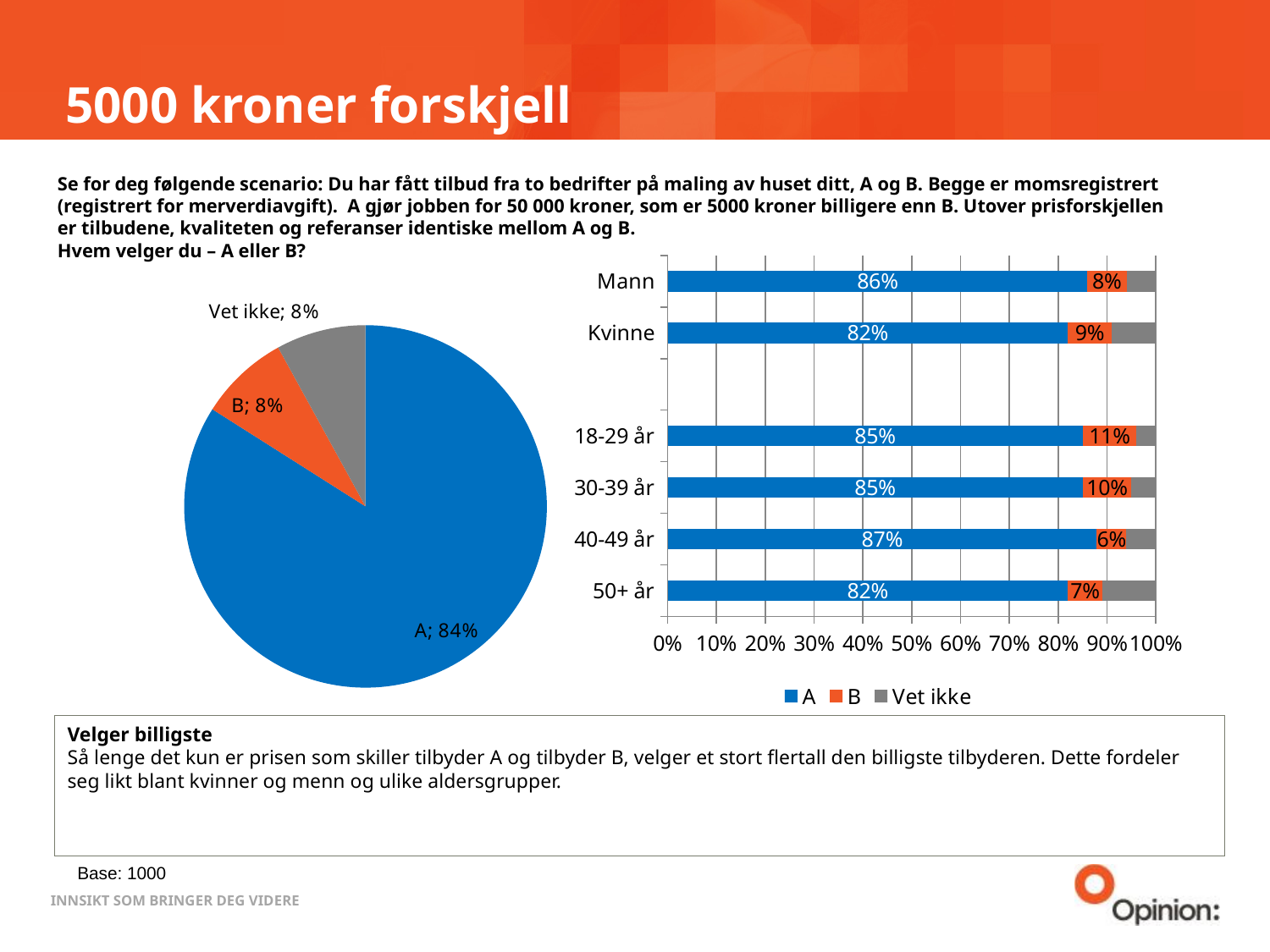
In the pie chart on the left, what share of respondents chose A? 84% In the pie chart on the left, what share of respondents answered 'Vet ikke'? 8% In the bar chart on the right, which category has the lowest value for B? 40-49 år In the bar chart on the right, what is the value of B for 18-29 år? 11% In the pie chart on the left, which slice is the largest? A In the pie chart on the left, how many slices are there? 3 In the bar chart on the right, how many series does the legend list? 3 What type of chart is shown on the right side of the slide? Stacked bar chart In the bar chart on the right, what is the value of A for Mann? 86% In the bar chart on the right, is the value of B larger for 30-39 år or for 50+ år? 30-39 år In the bar chart on the right, which category has the highest value for A? 40-49 år In the bar chart on the right, what is the difference between the A values for Mann and Kvinne? 4%